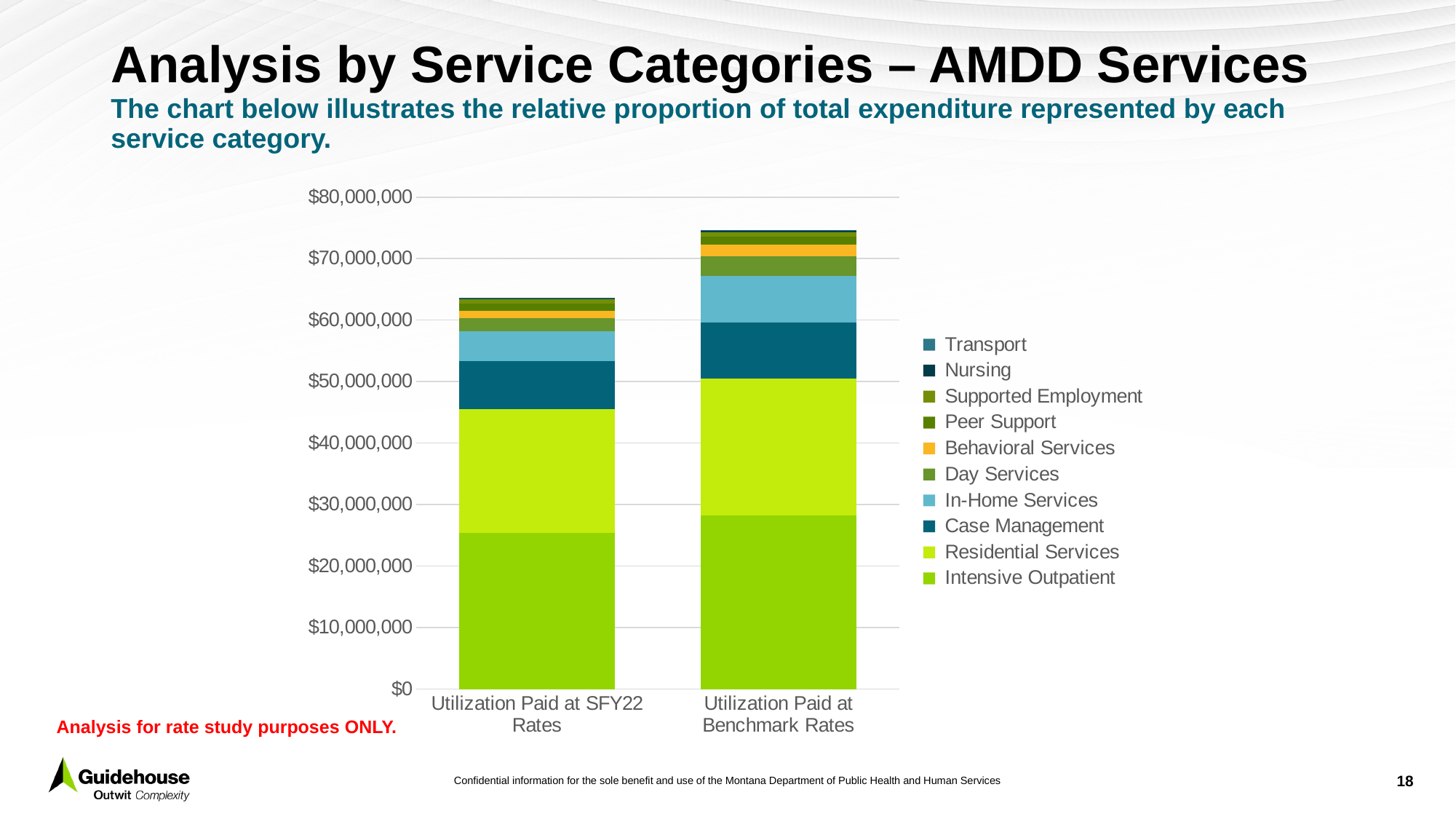
Is the Intensive Outpatient value for Utilization Paid at SFY22 Rates greater or less than $20,000,000? greater Is the Intensive Outpatient value for Utilization Paid at Benchmark Rates greater or less than $30,000,000? less Do the bar totals rise or fall from Utilization Paid at SFY22 Rates to Utilization Paid at Benchmark Rates? rise How many bars (categories) are plotted on the x axis? 2 What kind of chart is shown on the slide? Stacked bar chart Is the total of the Utilization Paid at Benchmark Rates bar greater or less than $70,000,000? greater Which series is plotted at the bottom of each stacked bar? Intensive Outpatient Which series forms the largest segment of the Utilization Paid at SFY22 Rates bar? Intensive Outpatient Which series is listed first (at the top) in the legend? Transport How many series does the legend list? 10 Which bar has the greater total, Utilization Paid at SFY22 Rates or Utilization Paid at Benchmark Rates? Utilization Paid at Benchmark Rates